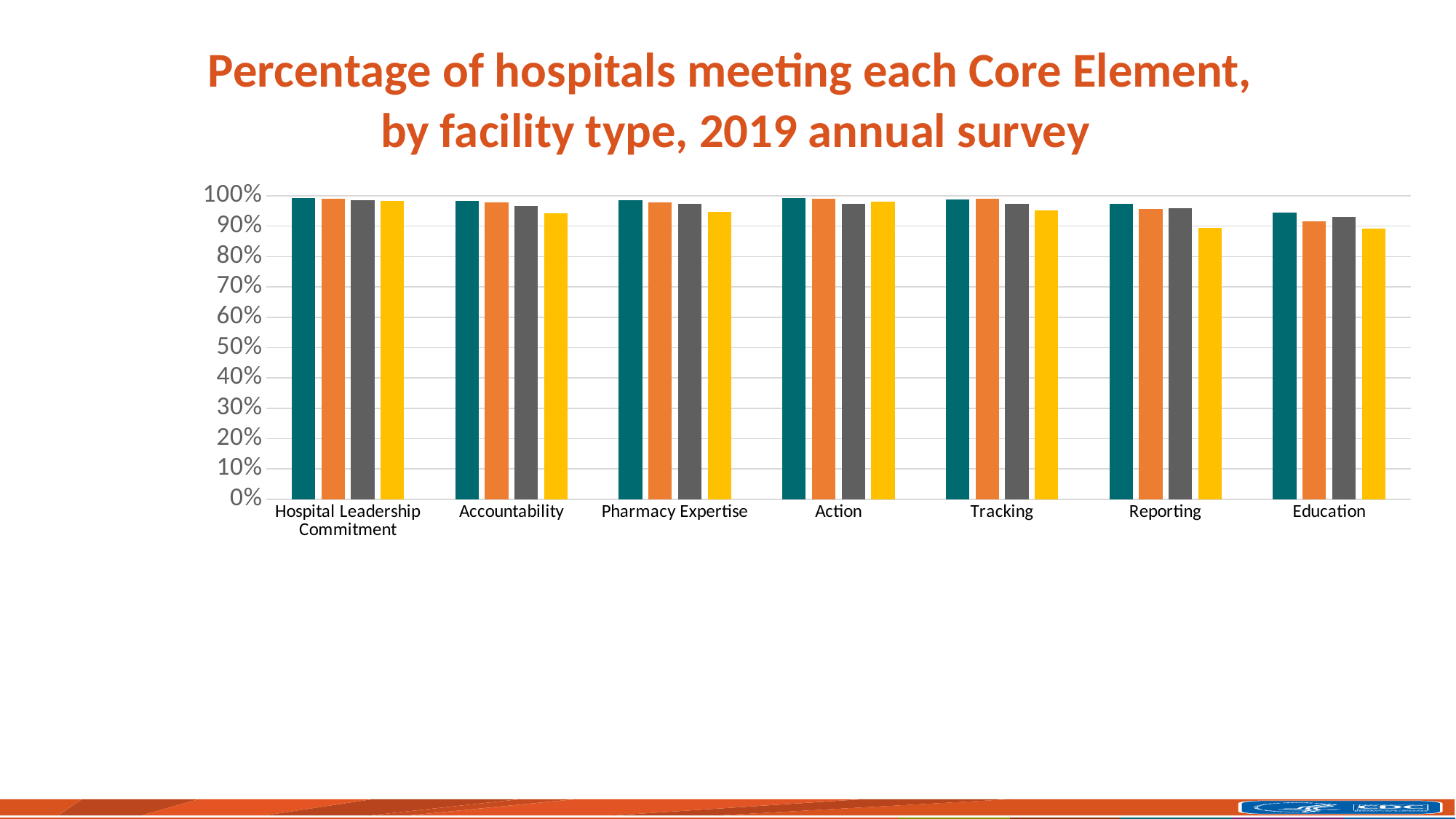
Which Core Element has the lowest teal bar? Education For Education, which is larger: the teal bar or the orange bar? teal bar What kind of chart is shown on the slide? bar chart Is the value of the yellow bar for Accountability greater or less than 90%? greater Is the value of the orange bar for Education greater or less than 80%? greater Which Core Element has the lowest orange bar? Education For Reporting, which is larger: the teal bar or the yellow bar? teal bar Is the value of the yellow bar for Reporting greater or less than 80%? greater How many Core Element categories are shown on the x axis? 7 What is the title of the chart? Percentage of hospitals meeting each Core Element, by facility type, 2019 annual survey How many bars are plotted for each Core Element category? 4